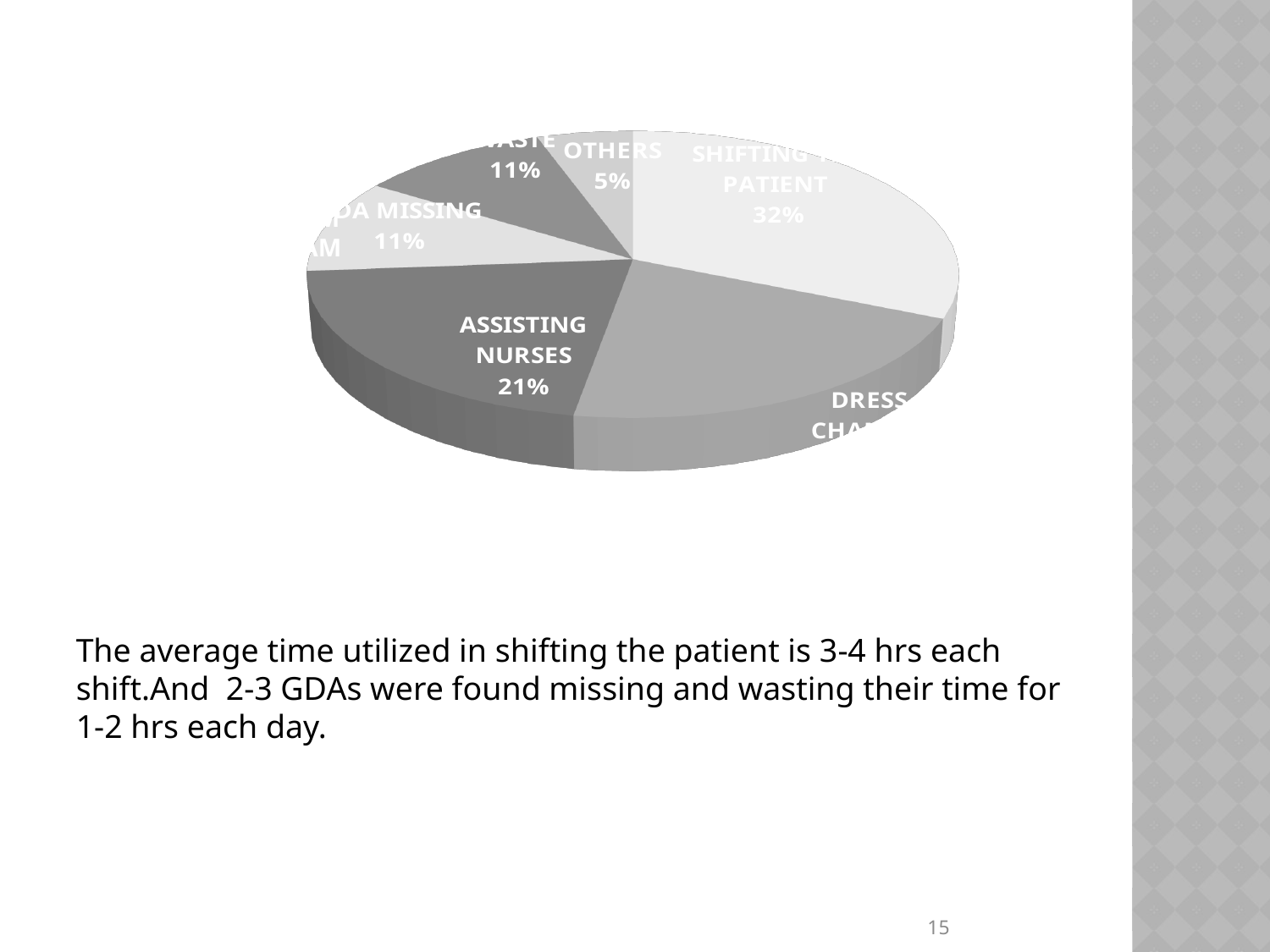
Which is larger, the ASSISTING NURSES slice or the OTHERS slice? ASSISTING NURSES How many slices does the pie chart have? 6 How many percentage points larger is the SHIFTING PATIENT slice than the ASSISTING NURSES slice? 11 percentage points How many percentage points larger is the ASSISTING NURSES slice than the OTHERS slice? 16 percentage points What percentage of the pie is labelled SHIFTING PATIENT? 32% What percentage of the pie is labelled OTHERS? 5% Which slice of the pie chart is the largest? SHIFTING PATIENT What percentage of the pie is labelled ASSISTING NURSES? 21% What share of the pie does SHIFTING PATIENT account for? 32% What kind of chart is shown on the slide? pie chart Which is larger, the SHIFTING PATIENT slice or the ASSISTING NURSES slice? SHIFTING PATIENT Which slice of the pie chart is the smallest? OTHERS